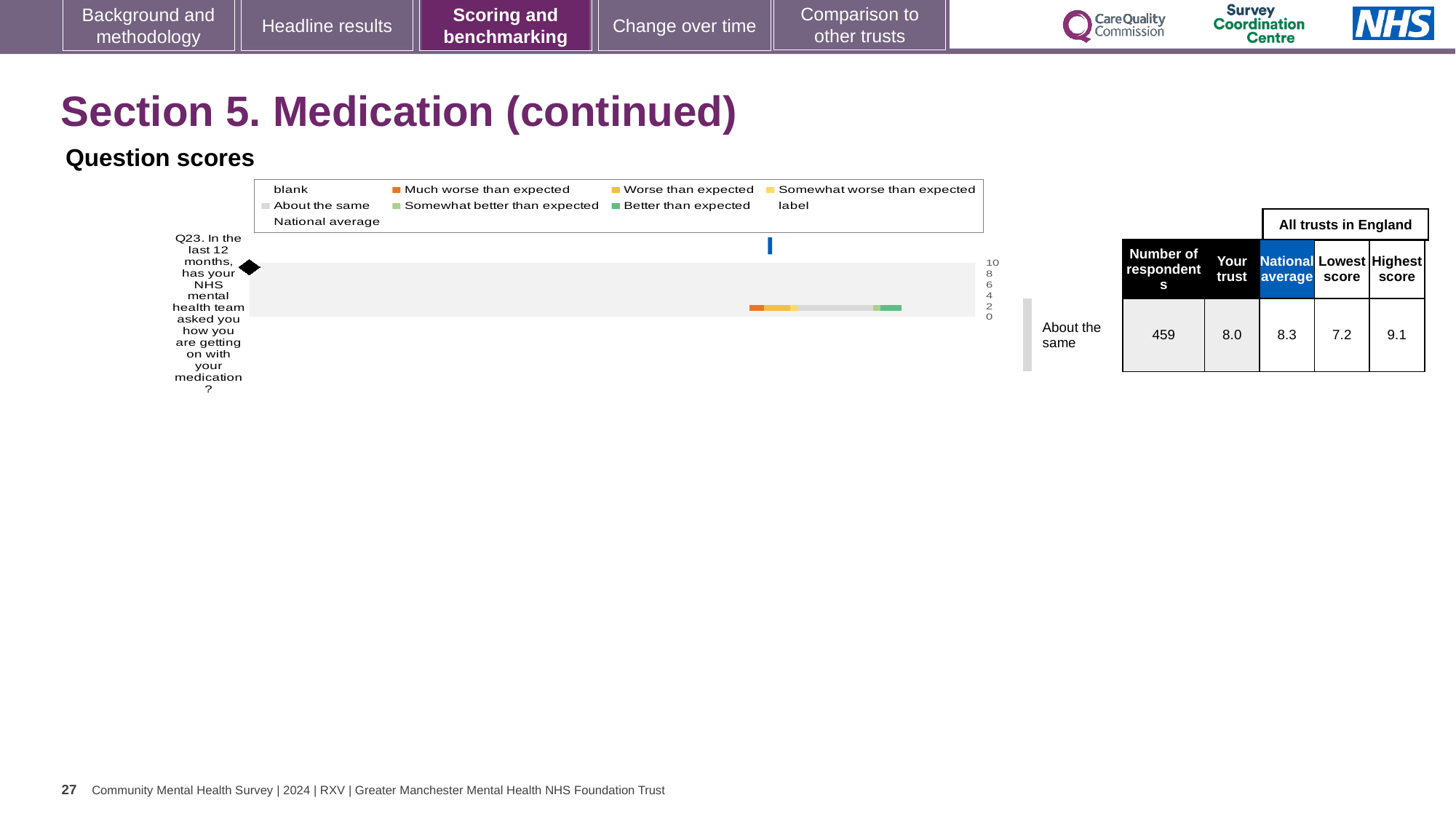
What is the number of respondents for Q23 shown next to the chart? 459 What is the difference between the highest and lowest scores among all trusts in England for Q23? 1.9 What is the national average score for Q23? 8.3 What is the "Your trust" score for Q23? 8.0 What is the highest value shown on the score axis of the Question scores chart? 10 How many survey questions are plotted in the Question scores chart? 1 What kind of chart is shown under "Question scores"? bar chart Which question is plotted in the Question scores chart? Q23. In the last 12 months, has your NHS mental health team asked you how you are getting on with your medication? What is the highest score among all trusts in England for Q23? 9.1 What is the lowest score among all trusts in England for Q23? 7.2 What is the difference between the national average and the "Your trust" score for Q23? 0.3 Which is larger for Q23, the "Your trust" score or the national average? National average